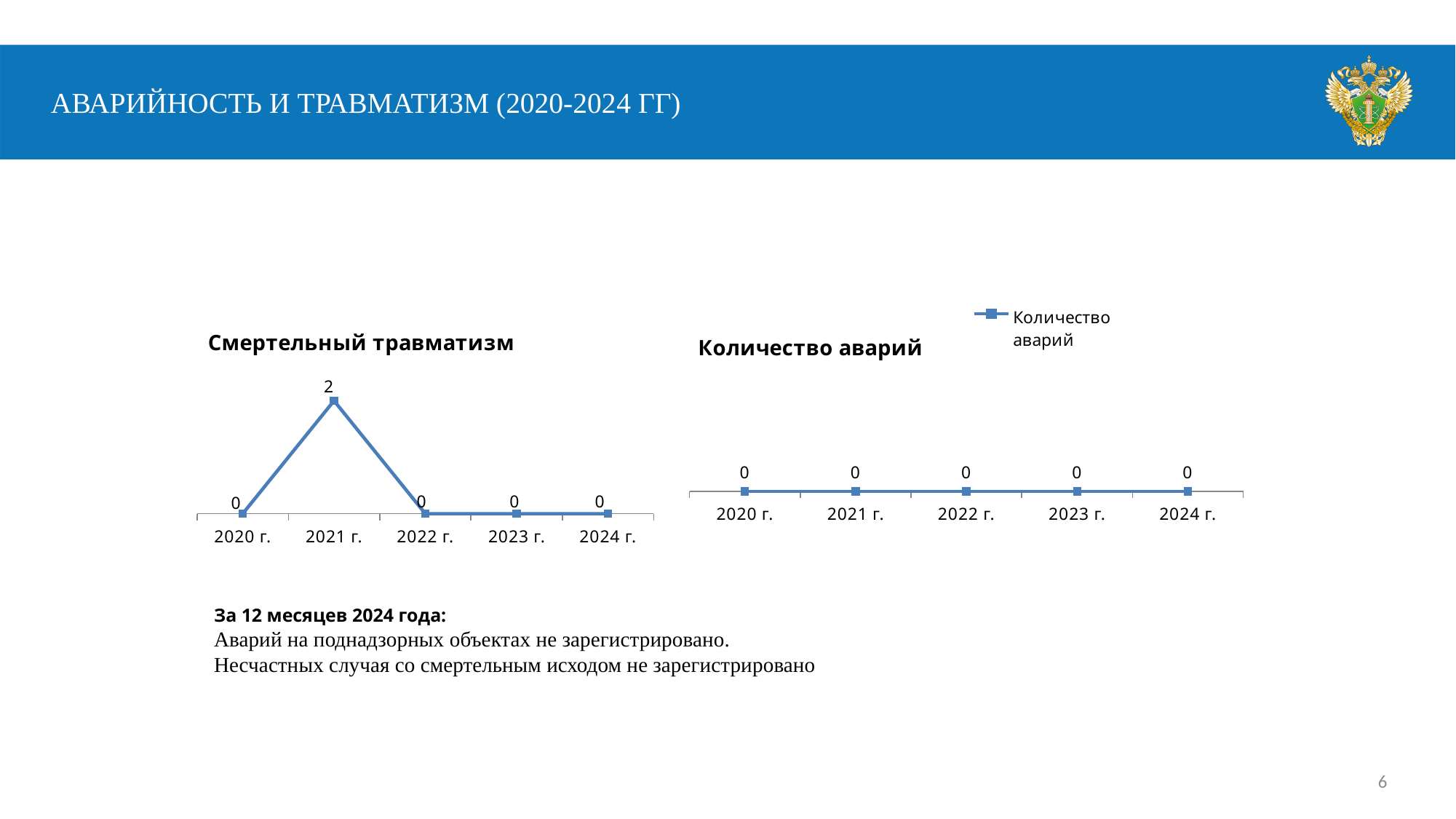
In the 'Количество аварий' chart, do the values rise, fall or stay flat from 2020 г. to 2024 г.? Stay flat What is the legend entry in the 'Количество аварий' chart? Количество аварий What kind of chart is the 'Смертельный травматизм' chart? Line chart In the 'Смертельный травматизм' chart, what is the value for 2020 г.? 0 In the 'Смертельный травматизм' chart, what is the difference between the values for 2021 г. and 2022 г.? 2 How many data points are plotted in the 'Смертельный травматизм' chart? 5 In the 'Смертельный травматизм' chart, which is larger, the value for 2021 г. or the value for 2023 г.? 2021 г. In the 'Смертельный травматизм' chart, what is the value for 2021 г.? 2 How many series does the legend of the 'Количество аварий' chart list? 1 In the 'Количество аварий' chart, what is the value for 2024 г.? 0 In the 'Смертельный травматизм' chart, which year has the highest value? 2021 г. In the 'Количество аварий' chart, what is the value for 2022 г.? 0